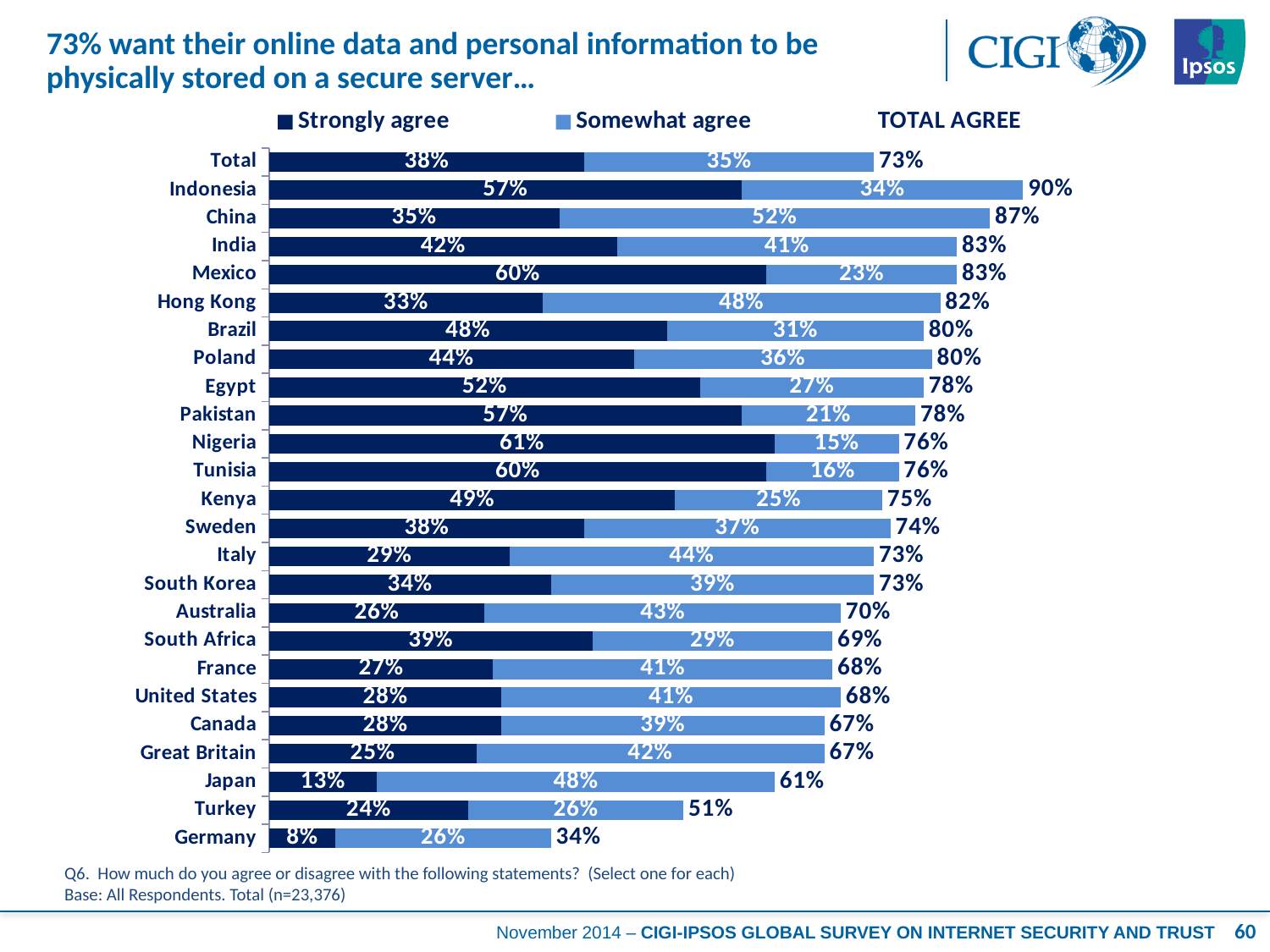
What is the difference between the TOTAL AGREE values for Indonesia and Germany? 56% What is the total of the stacked bar for Nigeria? 76% What is the TOTAL AGREE value for Japan? 61% What kind of chart is shown on the slide? Bar chart Which series is shown in dark navy blue? Strongly agree What is the 'Strongly agree' value for Indonesia? 57% Which has a larger 'Strongly agree' value, Mexico or Brazil? Mexico What is the 'Somewhat agree' value for China? 52% Which country has the highest TOTAL AGREE value? Indonesia How many categories (rows) are shown in the chart, including Total? 25 Which country has the lowest 'Strongly agree' value? Germany How many series does the legend list? 2